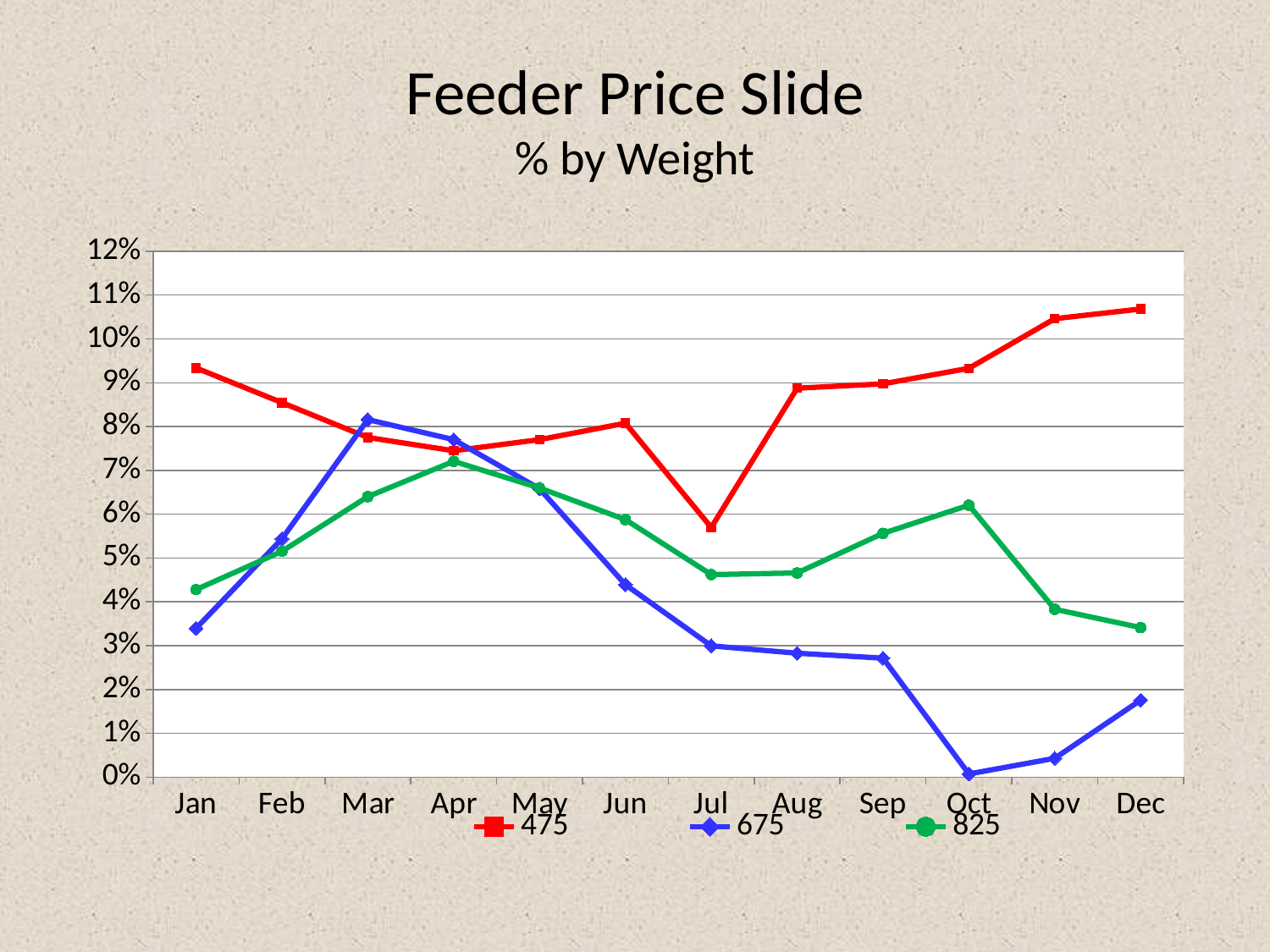
In which month does the 475 series reach its highest value? Dec In which month does the 675 series reach its highest value? Mar In which month does the 675 series reach its lowest value? Oct How many months are plotted along the x axis? 12 Is the value for the 675 series in Oct greater or less than 1%? less In which month does the 475 series reach its lowest value? Jul Is the value for the 475 series in Nov greater or less than 10%? greater How many series does the legend list? 3 In which month does the 825 series reach its highest value? Apr What kind of chart is shown on the slide? line chart Does the 675 series rise or fall from Mar to Oct? fall In Dec, which series has the larger value, 825 or 675? 825